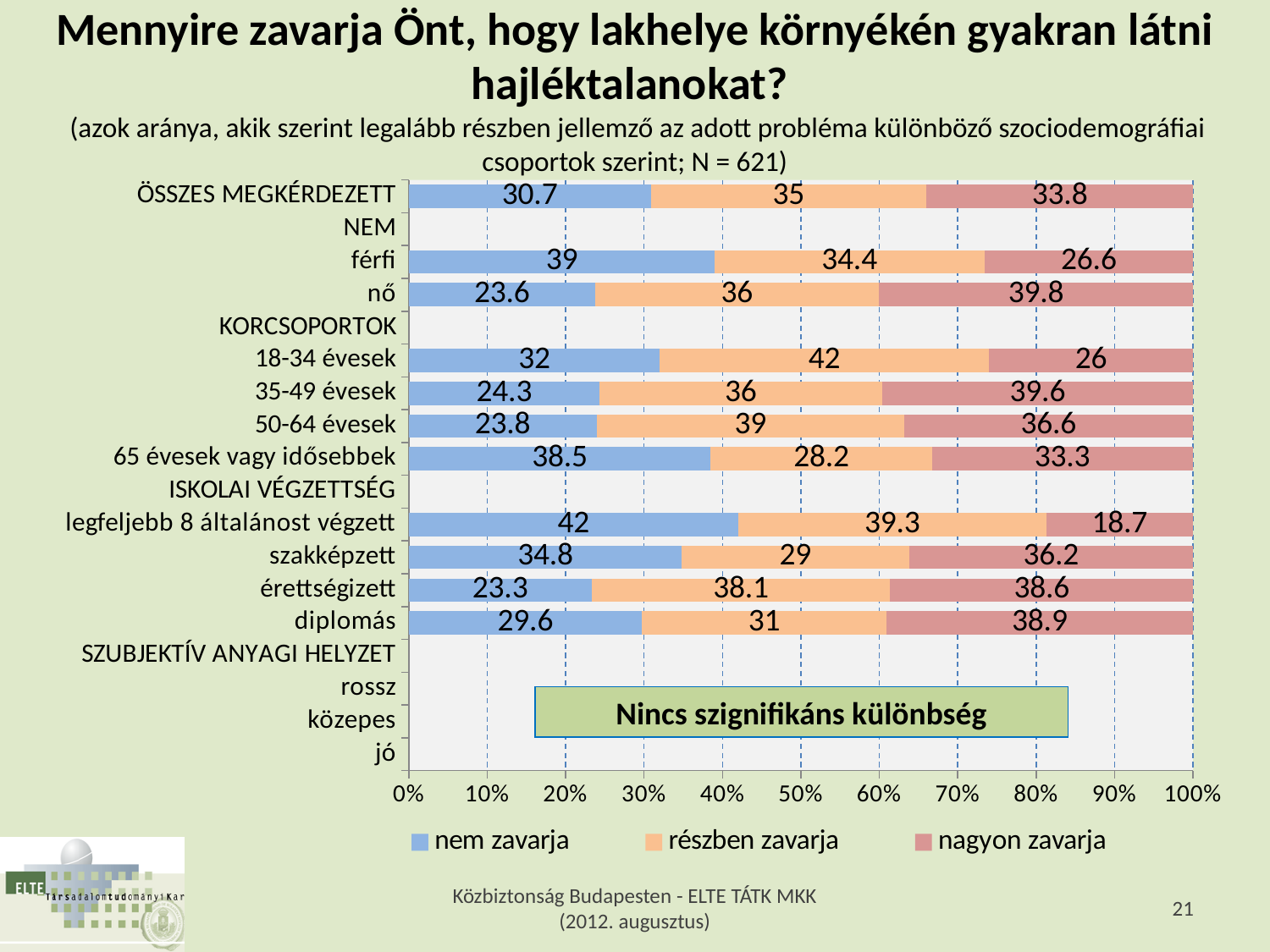
What is the value of 'nagyon zavarja' for diplomás? 38.9 Which has a larger 'nem zavarja' value, férfi or nő? férfi What is the value of 'részben zavarja' for 18-34 évesek? 42 Which category has the lowest 'nagyon zavarja' value? legfeljebb 8 általánost végzett Which category has the highest 'nem zavarja' value? legfeljebb 8 általánost végzett What kind of chart is shown on the slide? stacked bar chart What is the difference between the 'nagyon zavarja' values for nő and férfi? 13.2 How many series does the legend list? 3 What is the total of the three values in the ÖSSZES MEGKÉRDEZETT bar? 99.5 What is the value of 'nagyon zavarja' for férfi? 26.6 What is the value of 'nem zavarja' for ÖSSZES MEGKÉRDEZETT? 30.7 What text is shown in the box over the SZUBJEKTÍV ANYAGI HELYZET rows? Nincs szignifikáns különbség